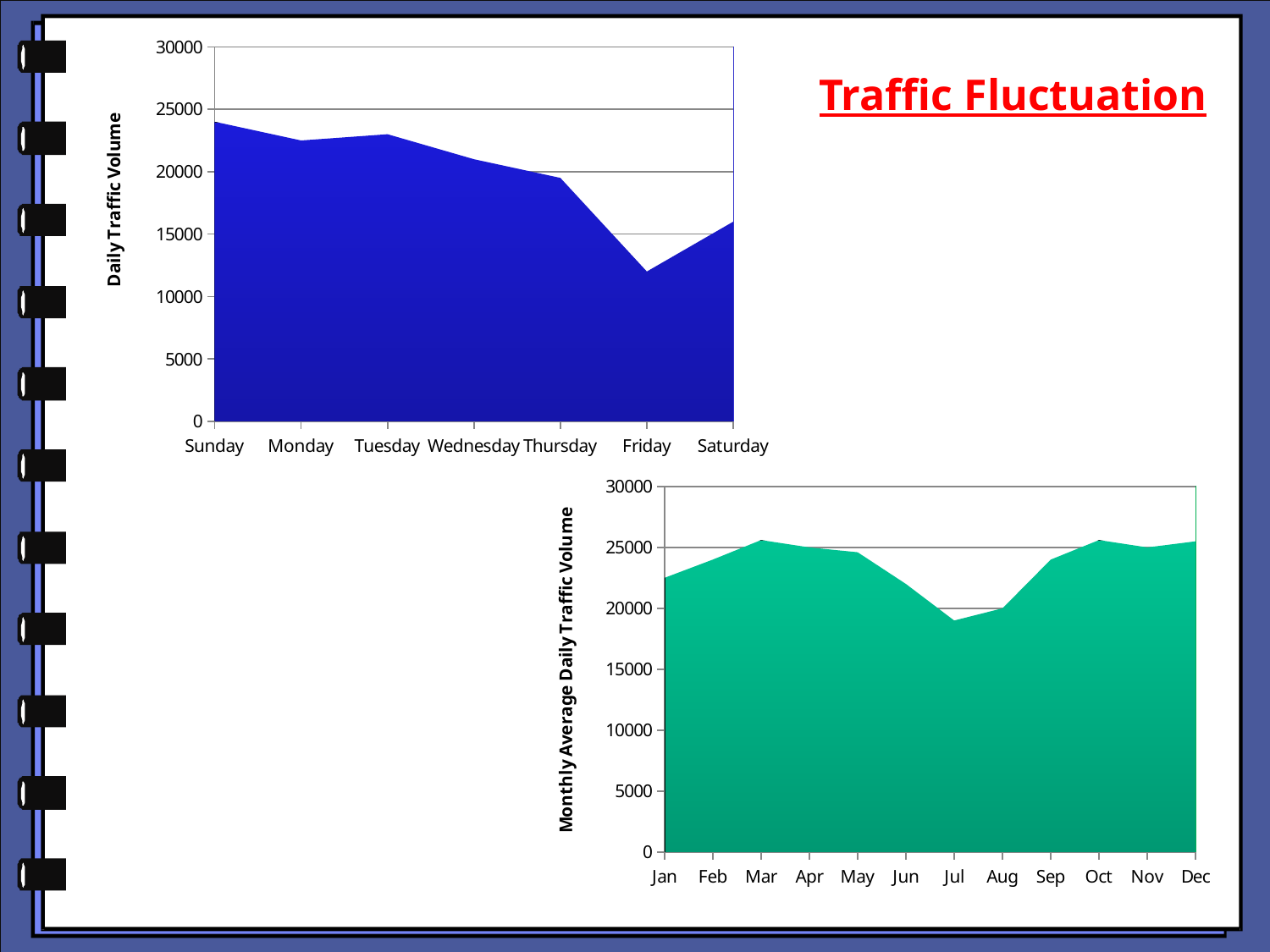
What kind of chart is the top chart on the slide (the one with days of the week)? area chart In the top chart (Daily Traffic Volume), do the values generally rise or fall from Sunday to Friday? fall What is the y-axis title of the bottom chart on the slide? Monthly Average Daily Traffic Volume In the top chart (Daily Traffic Volume), which day has the lowest traffic volume? Friday How many months are plotted along the x axis of the bottom chart (Monthly Average Daily Traffic Volume)? 12 In the bottom chart (Monthly Average Daily Traffic Volume), is the value for Jul greater or less than 20000? less How many days are plotted along the x axis of the top chart (Daily Traffic Volume)? 7 In the top chart (Daily Traffic Volume), is the value for Sunday greater or less than 20000? greater In the top chart (Daily Traffic Volume), which is larger, the value for Thursday or the value for Saturday? Thursday In the bottom chart (Monthly Average Daily Traffic Volume), which month has the lowest value? Jul In the top chart (Daily Traffic Volume), is the value for Friday greater or less than 15000? less In the top chart (Daily Traffic Volume), which day has the highest traffic volume? Sunday